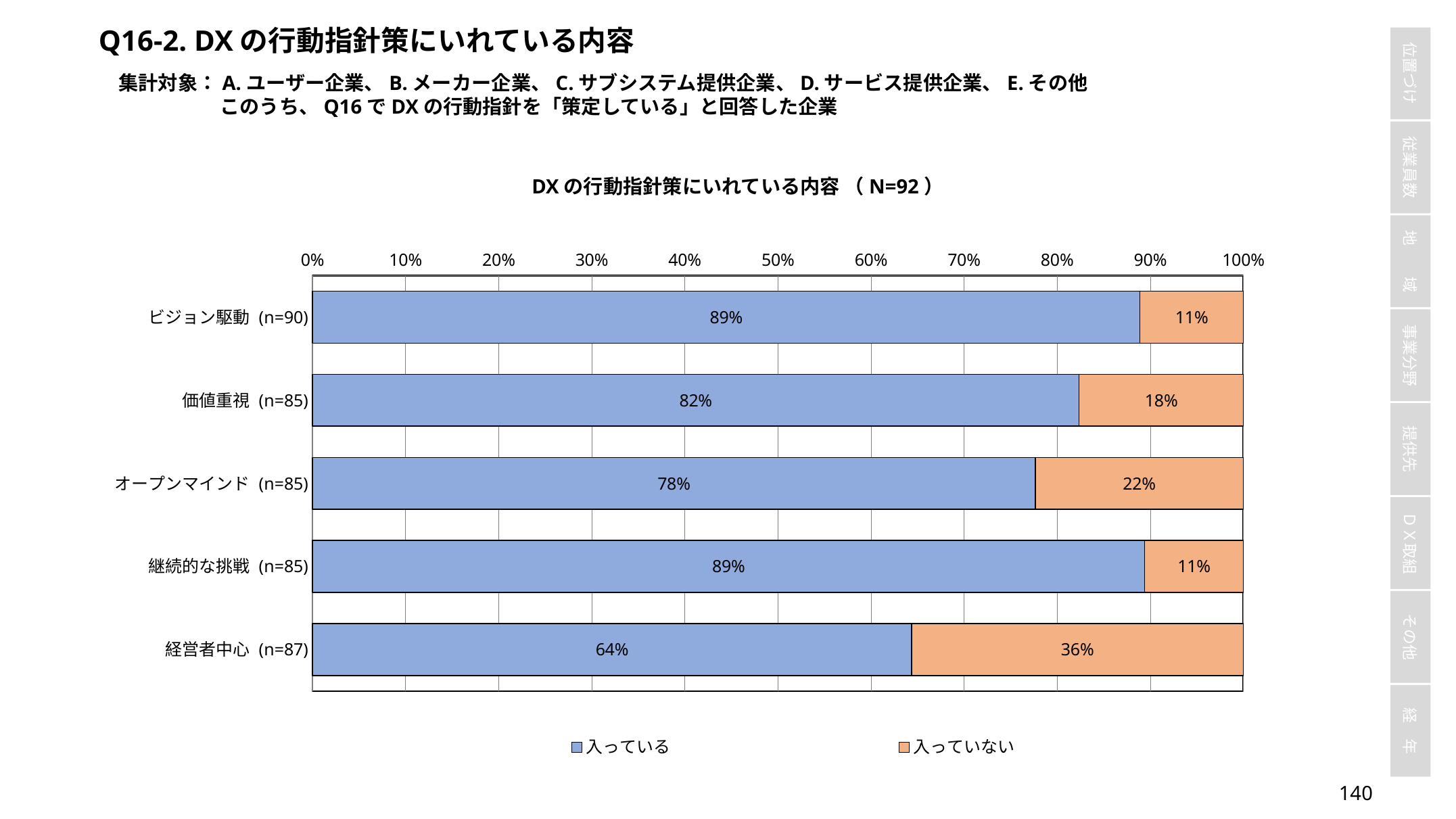
What percentage of respondents answered 入っている for ビジョン駆動 (n=90)? 89% Which has a larger 入っていない value, オープンマインド (n=85) or 価値重視 (n=85)? オープンマインド (n=85) How many series does the legend list? 2 What kind of chart is shown on the slide? Stacked bar chart How many categories are shown in the chart? 5 Which category has the lowest 入っている percentage? 経営者中心 (n=87) What percentage of respondents answered 入っていない for 経営者中心 (n=87)? 36% What is the difference between the 入っている values for 価値重視 (n=85) and 経営者中心 (n=87)? 18% What is the 入っていない value for 価値重視 (n=85)? 18% Which category has the highest 入っていない percentage? 経営者中心 (n=87) What is the total of the stacked bar for 継続的な挑戦 (n=85)? 100% What is the 入っている value for オープンマインド (n=85)? 78%